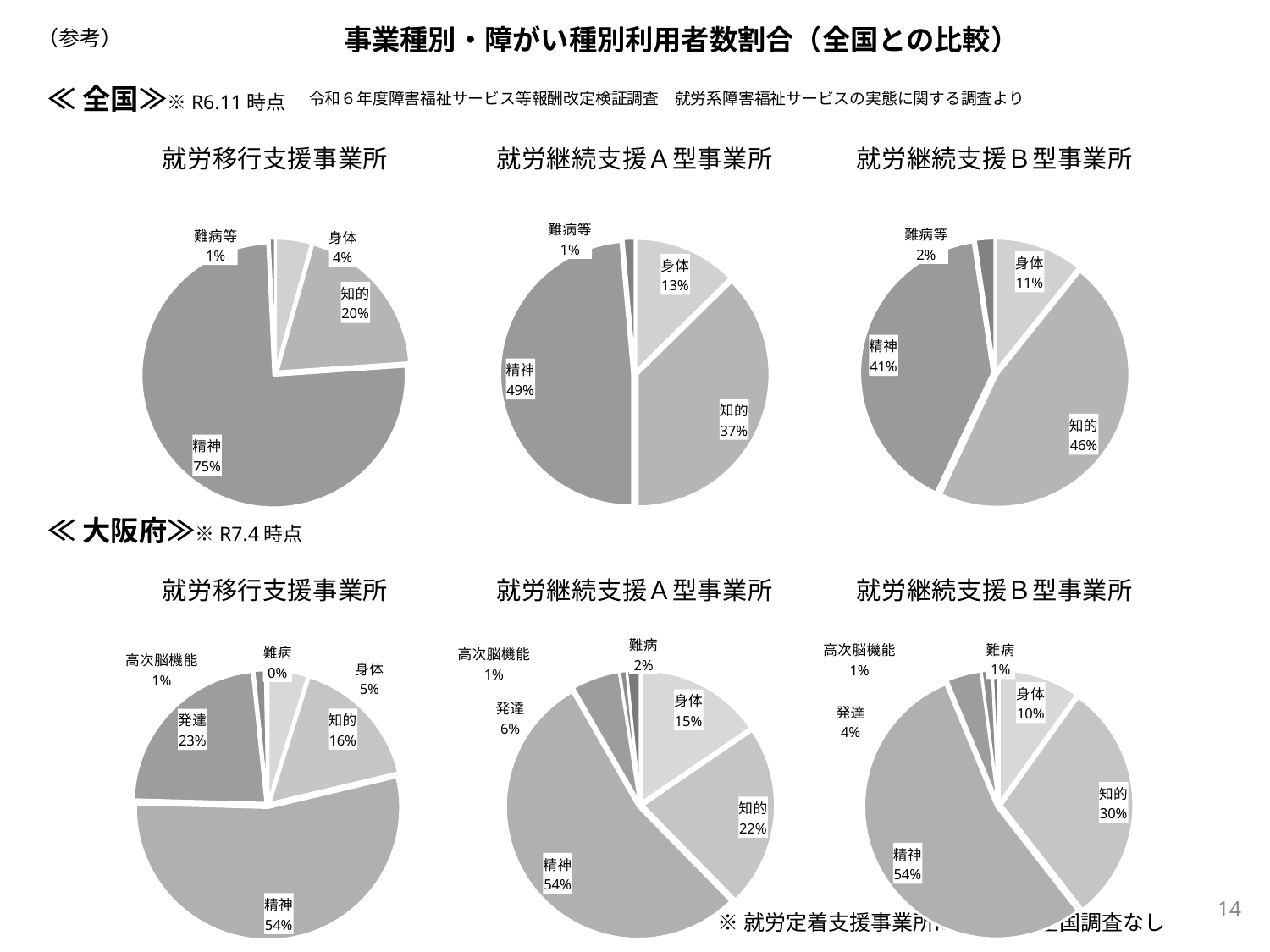
In the 大阪府 就労移行支援事業所 pie chart, what share is 発達? 23% What kind of chart is used for the 全国 就労継続支援Ａ型事業所 data? Pie chart In the 大阪府 就労移行支援事業所 pie chart, which category has the smallest share? 難病 How many categories does the 大阪府 就労継続支援Ｂ型事業所 pie chart show? 6 In the 全国 就労継続支援Ａ型事業所 pie chart, what share is 知的? 37% In the 全国 就労継続支援Ｂ型事業所 pie chart, which category has the largest share? 知的 In the 全国 就労移行支援事業所 pie chart, what share is 精神? 75% In the 全国 就労継続支援Ｂ型事業所 pie chart, what is the difference between the 知的 and 精神 shares? 5% How many pie charts are shown on the slide in total? 6 In the 大阪府 就労継続支援Ａ型事業所 pie chart, what share is 身体? 15% In the 大阪府 就労継続支援Ａ型事業所 pie chart, which is larger, 知的 or 身体? 知的 In the 大阪府 就労継続支援Ｂ型事業所 pie chart, what share is 知的? 30%